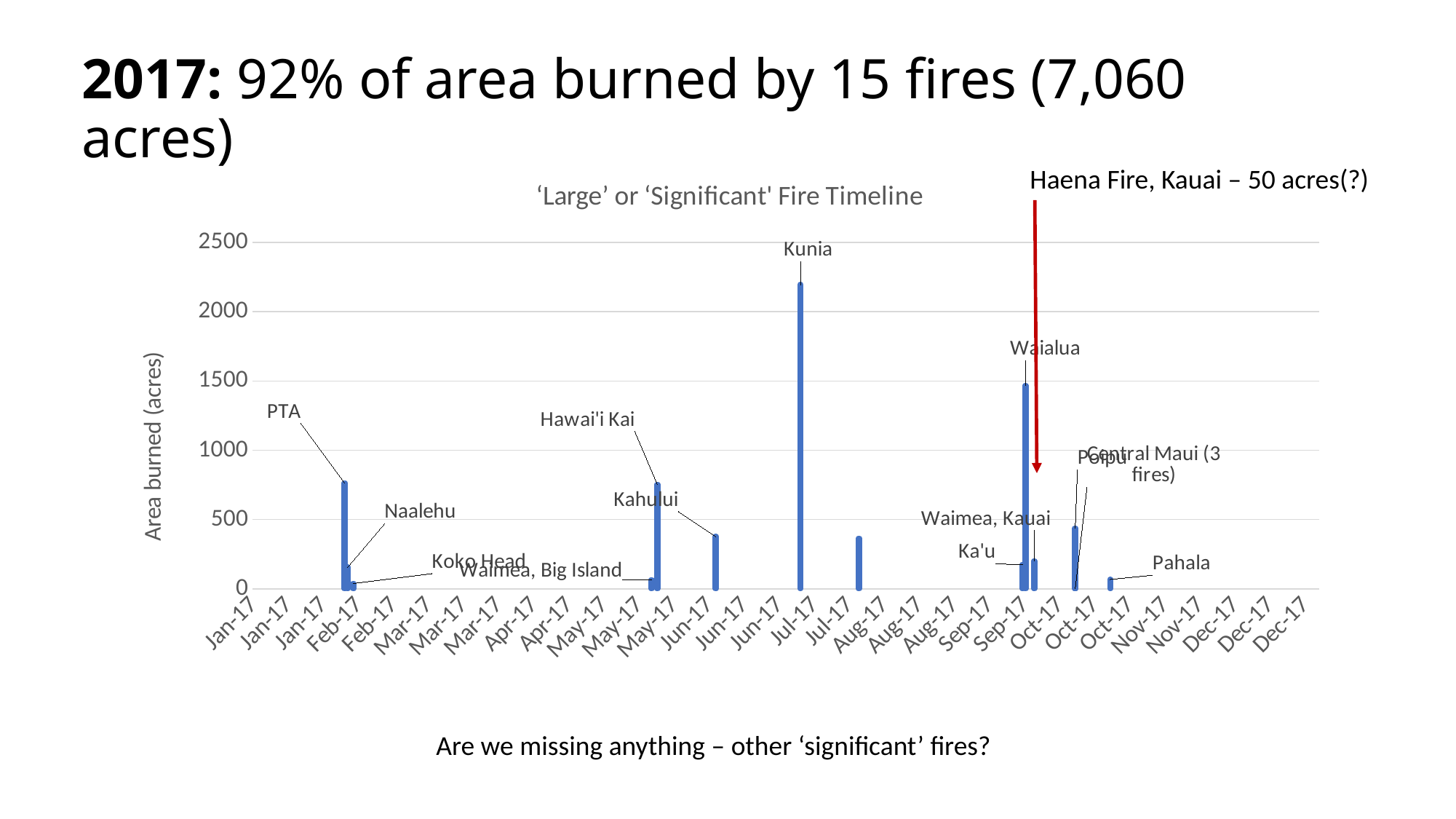
What kind of chart is shown on the slide? bar chart Is the area burned by the Kahului fire greater or less than 500 acres? less Which fire has the largest area burned in the chart? Kunia Is the area burned by the PTA fire greater or less than 1000 acres? less Is the area burned by the Waialua fire greater or less than 1000 acres? greater Which fire burned more area, Waialua or Poipu? Waialua Which fire burned more area, PTA or Koko Head? PTA Which fire burned more area, Kunia or Waialua? Kunia What is the label of the vertical axis of the chart? Area burned (acres) What is the title of the chart? ‘Large’ or ‘Significant' Fire Timeline